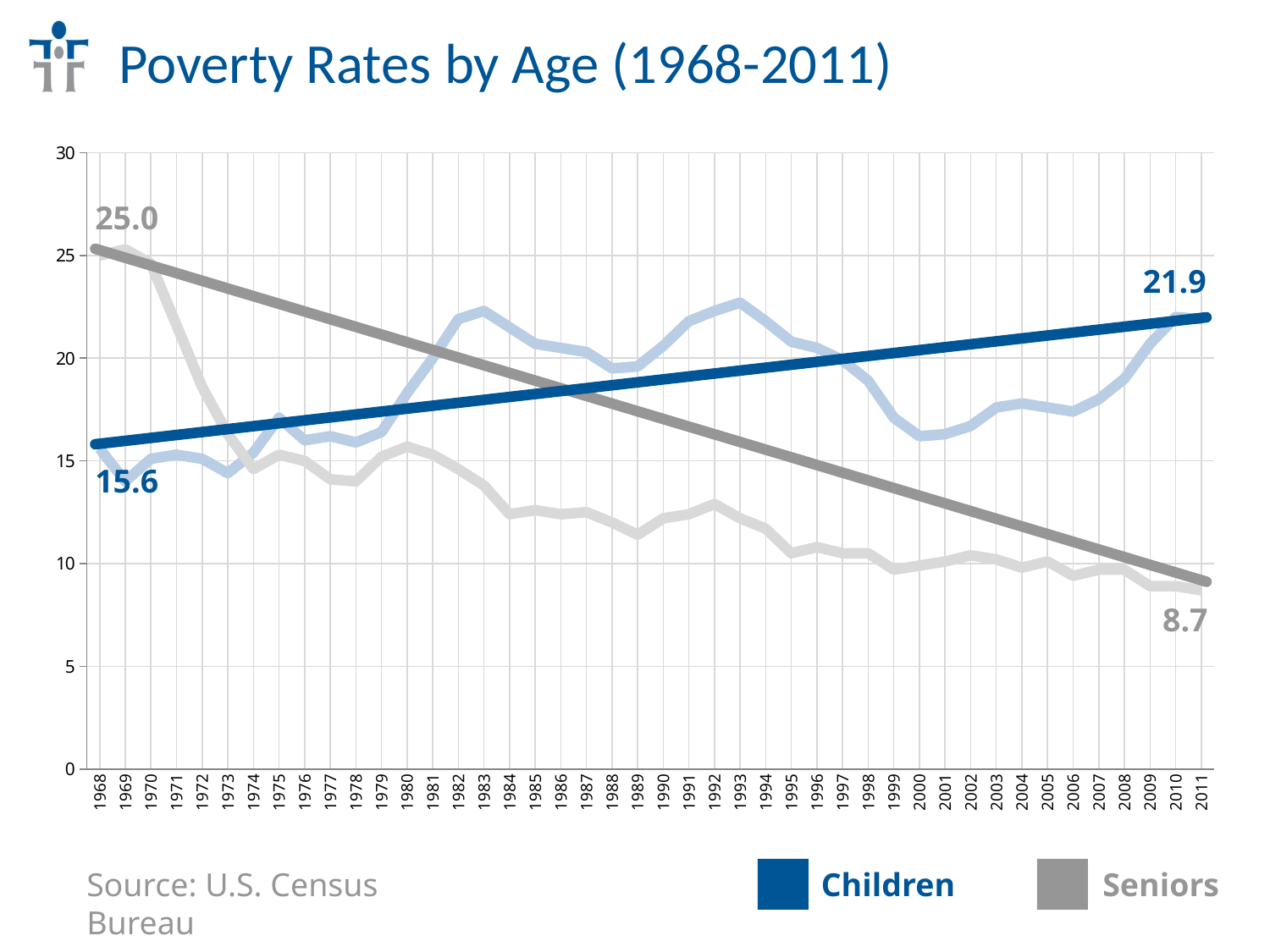
What is the poverty rate for Children in 1968? 15.6 Does the Seniors poverty rate rise or fall from 1968 to 2011? Fall By how much did the Children poverty rate change between 1968 and 2011? 6.3 In 2011, which group has the higher poverty rate, Children or Seniors? Children What is the poverty rate for Seniors in 2011? 8.7 What kind of chart is shown on the slide? Line chart What is the source cited for the chart? U.S. Census Bureau What is the difference between the Seniors poverty rate in 1968 and in 2011? 16.3 How many series does the legend list? 2 What is the poverty rate for Children in 2011? 21.9 Is the Seniors poverty rate in 1990 greater or less than 15? less What is the poverty rate for Seniors in 1968? 25.0